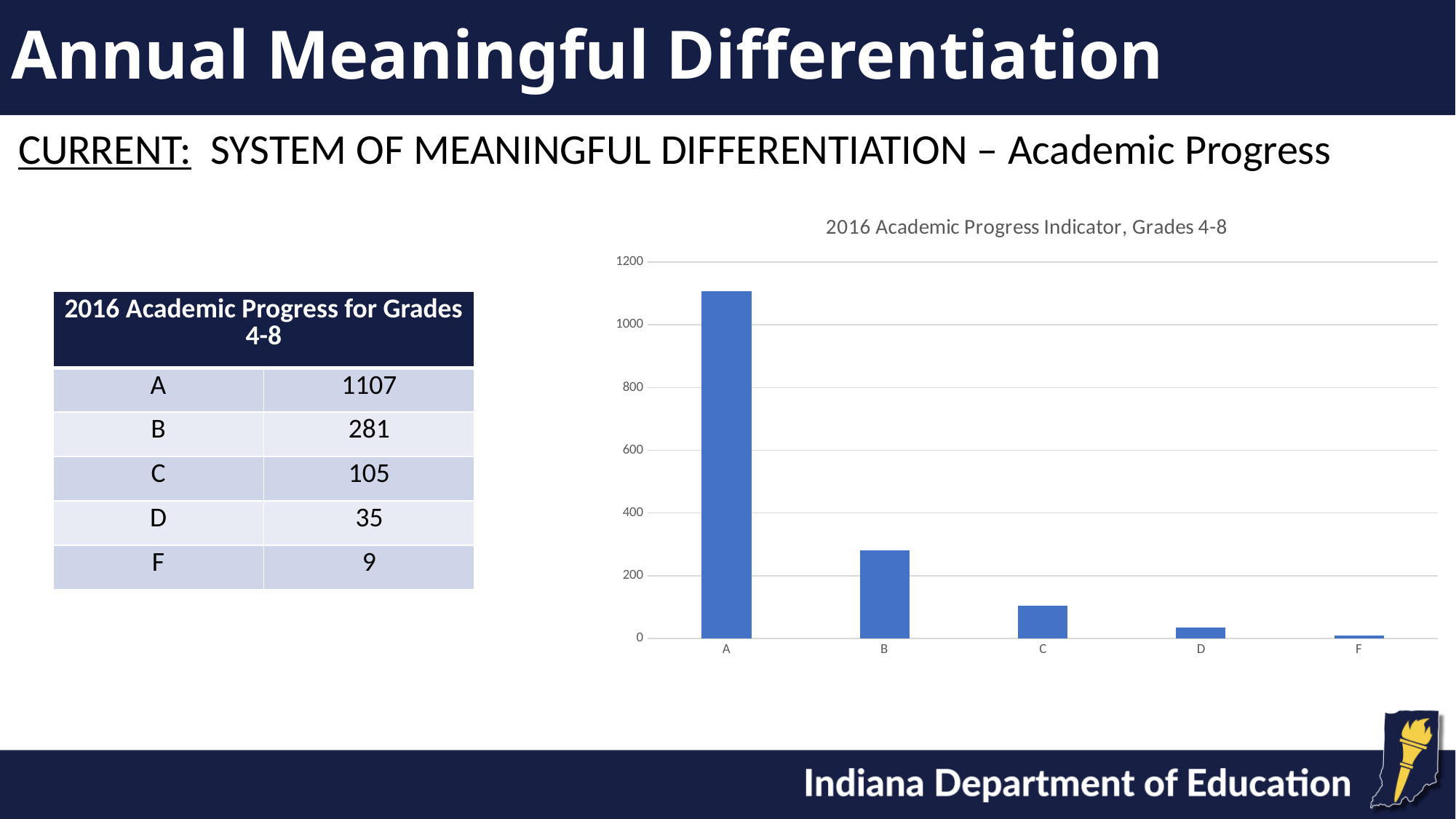
How many categories are shown on the x axis of the chart? 5 What is the title of the chart? 2016 Academic Progress Indicator, Grades 4-8 Which is larger, the value for B or the value for D? B What type of chart is shown on the slide? bar chart Which category has the lowest bar in the chart? F Do the values rise or fall moving from A to F along the x axis? fall According to the slide, what is the difference between the values for A and B? 826 Is the value for C greater or less than 200? less Is the value for A greater or less than 1000? greater According to the slide, what is the value for grade A in the 2016 Academic Progress data? 1107 Is the value for B greater or less than 400? less Which category has the highest bar in the chart? A